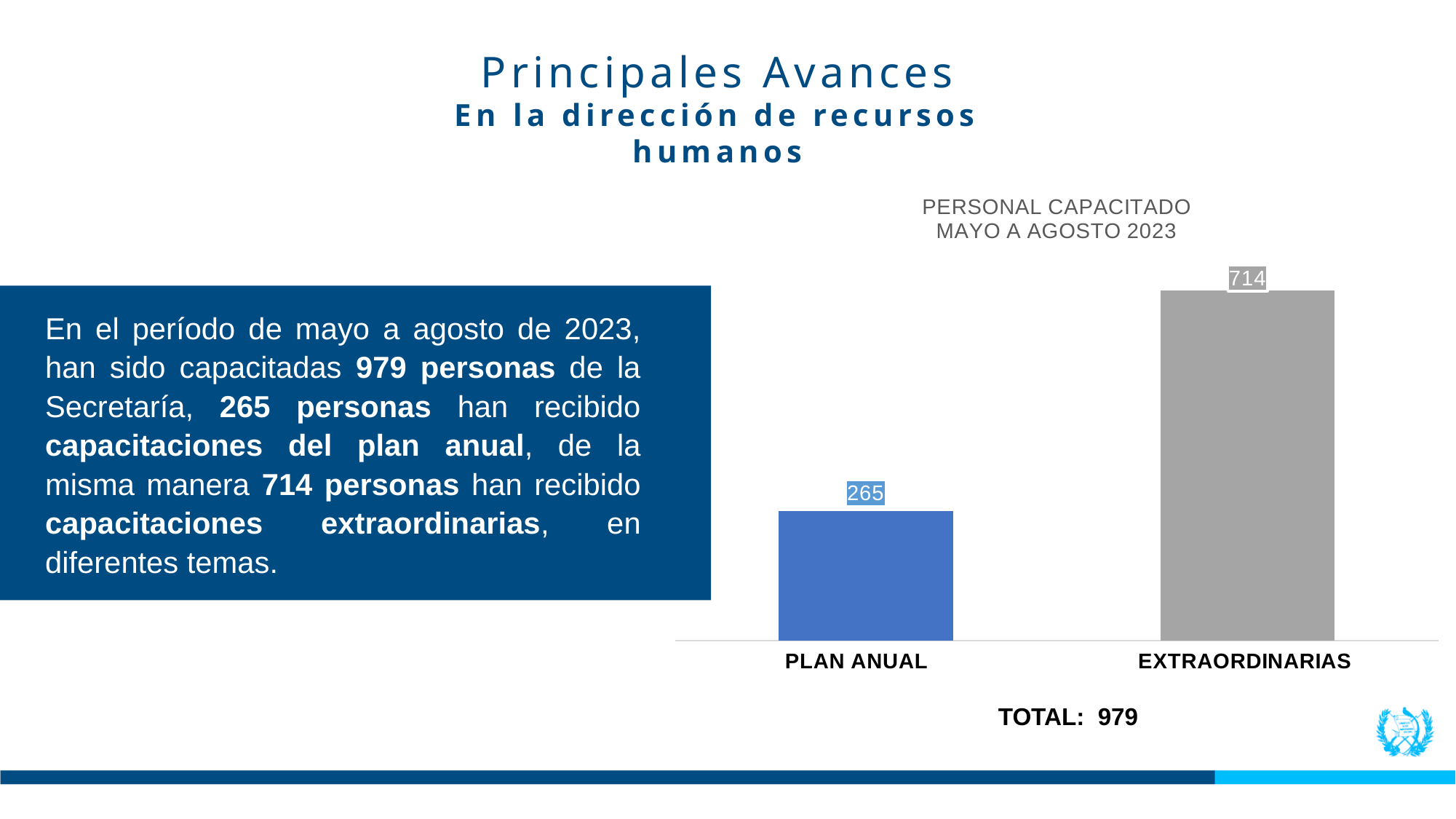
What is the title of the chart? PERSONAL CAPACITADO MAYO A AGOSTO 2023 What is the difference between the values for EXTRAORDINARIAS and PLAN ANUAL? 449 What is the total of the two values shown in the chart? 979 Which category has the lowest value? PLAN ANUAL What kind of chart is shown on the slide? bar chart How many categories are shown in the chart? 2 Which category has the highest value? EXTRAORDINARIAS What is the value for EXTRAORDINARIAS? 714 What is the value for PLAN ANUAL? 265 What colour is the bar for PLAN ANUAL? blue Which is larger, the value for PLAN ANUAL or the value for EXTRAORDINARIAS? EXTRAORDINARIAS